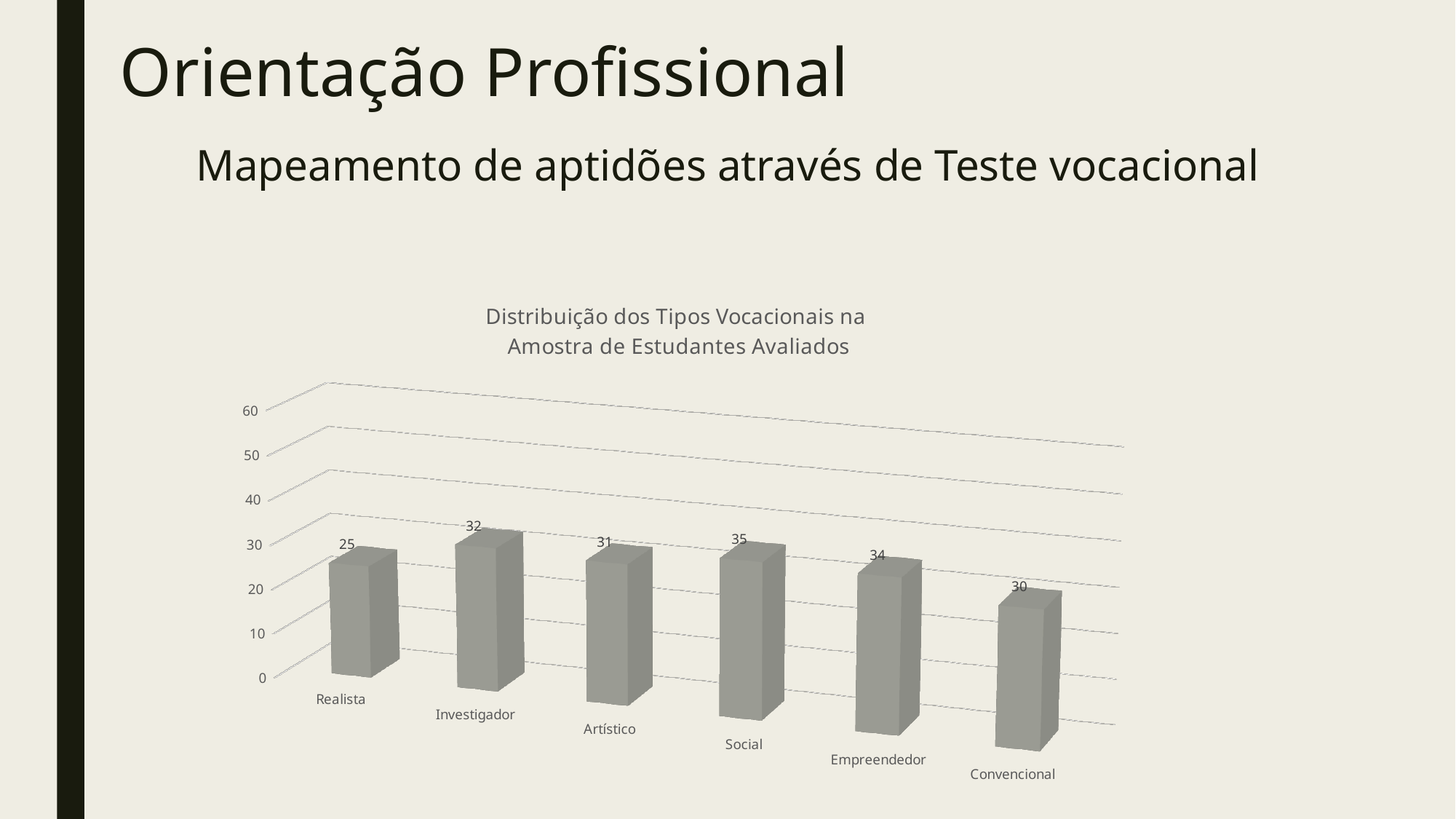
What is the value for Realista? 25 Which is larger, the value for Investigador or the value for Artístico? Investigador Is the value for Empreendedor greater or less than 30? greater What is the difference between the values for Social and Realista? 10 How many categories are shown in the chart? 6 What is the difference between the values for Empreendedor and Investigador? 2 What is the value for Convencional? 30 Which category has the highest value? Social What is the value for Social? 35 What kind of chart is shown on the slide? Bar chart Which category has the lowest value? Realista What is the title of the chart? Distribuição dos Tipos Vocacionais na Amostra de Estudantes Avaliados